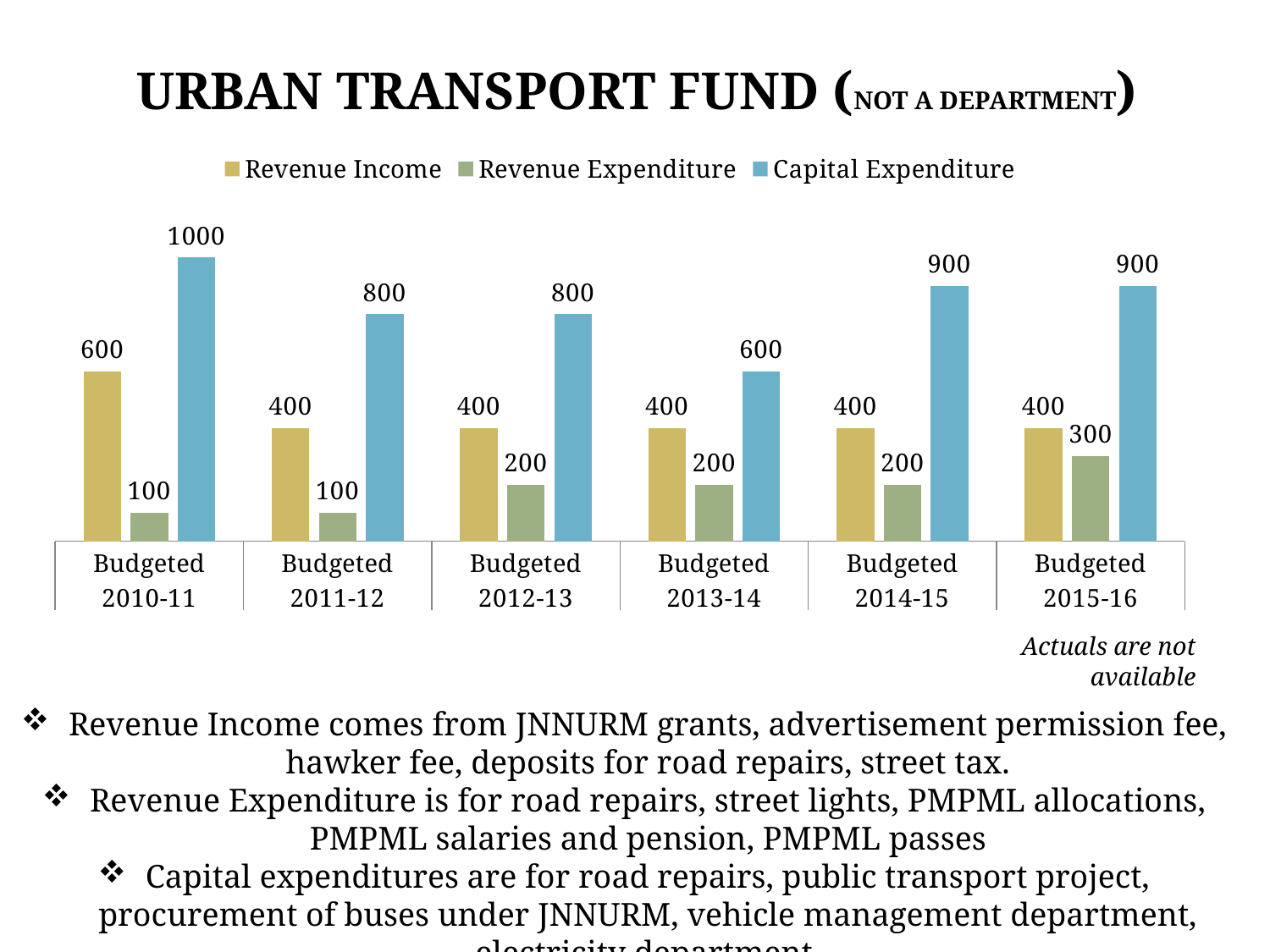
Does Revenue Expenditure rise or fall from Budgeted 2010-11 to Budgeted 2015-16? Rise What is the Capital Expenditure value for Budgeted 2010-11? 1000 What is the Revenue Expenditure value for Budgeted 2015-16? 300 Which budget year has the highest Capital Expenditure? Budgeted 2010-11 What kind of chart is shown on the slide? Bar chart Which budget year has the lowest Capital Expenditure? Budgeted 2013-14 How many budget years are shown on the x axis? 6 What is the Revenue Income value for Budgeted 2013-14? 400 Which series is shown in blue in the legend? Capital Expenditure What is the difference between Capital Expenditure and Revenue Income for Budgeted 2014-15? 500 Which is larger for Budgeted 2012-13: Revenue Income or Revenue Expenditure? Revenue Income How many series does the legend list? 3